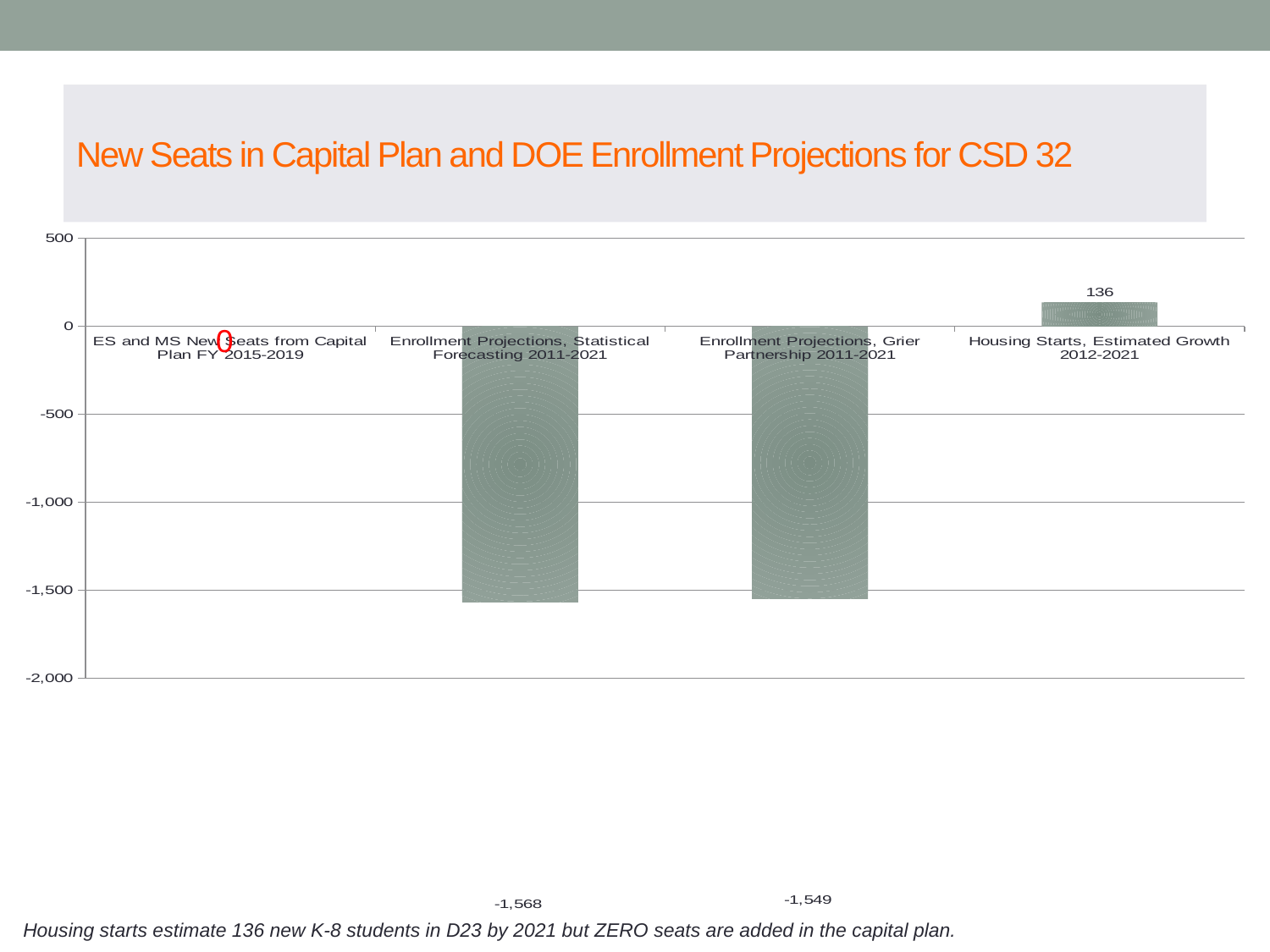
What kind of chart is shown on the slide? Bar chart What is the difference between the Housing Starts, Estimated Growth 2012-2021 value and the ES and MS New Seats from Capital Plan FY 2015-2019 value? 136 Which category has the lowest value? Enrollment Projections, Statistical Forecasting 2011-2021 What is the value for Housing Starts, Estimated Growth 2012-2021? 136 What is the difference between the Enrollment Projections, Statistical Forecasting 2011-2021 value and the Enrollment Projections, Grier Partnership 2011-2021 value? 19 How many categories are shown on the chart? 4 Which category has the highest value? Housing Starts, Estimated Growth 2012-2021 What is the title of the chart? New Seats in Capital Plan and DOE Enrollment Projections for CSD 32 What is the value for ES and MS New Seats from Capital Plan FY 2015-2019? 0 What is the value for Enrollment Projections, Grier Partnership 2011-2021? -1,549 What is the value for Enrollment Projections, Statistical Forecasting 2011-2021? -1,568 Which is larger, the value for Enrollment Projections, Grier Partnership 2011-2021 or the value for Enrollment Projections, Statistical Forecasting 2011-2021? Enrollment Projections, Grier Partnership 2011-2021